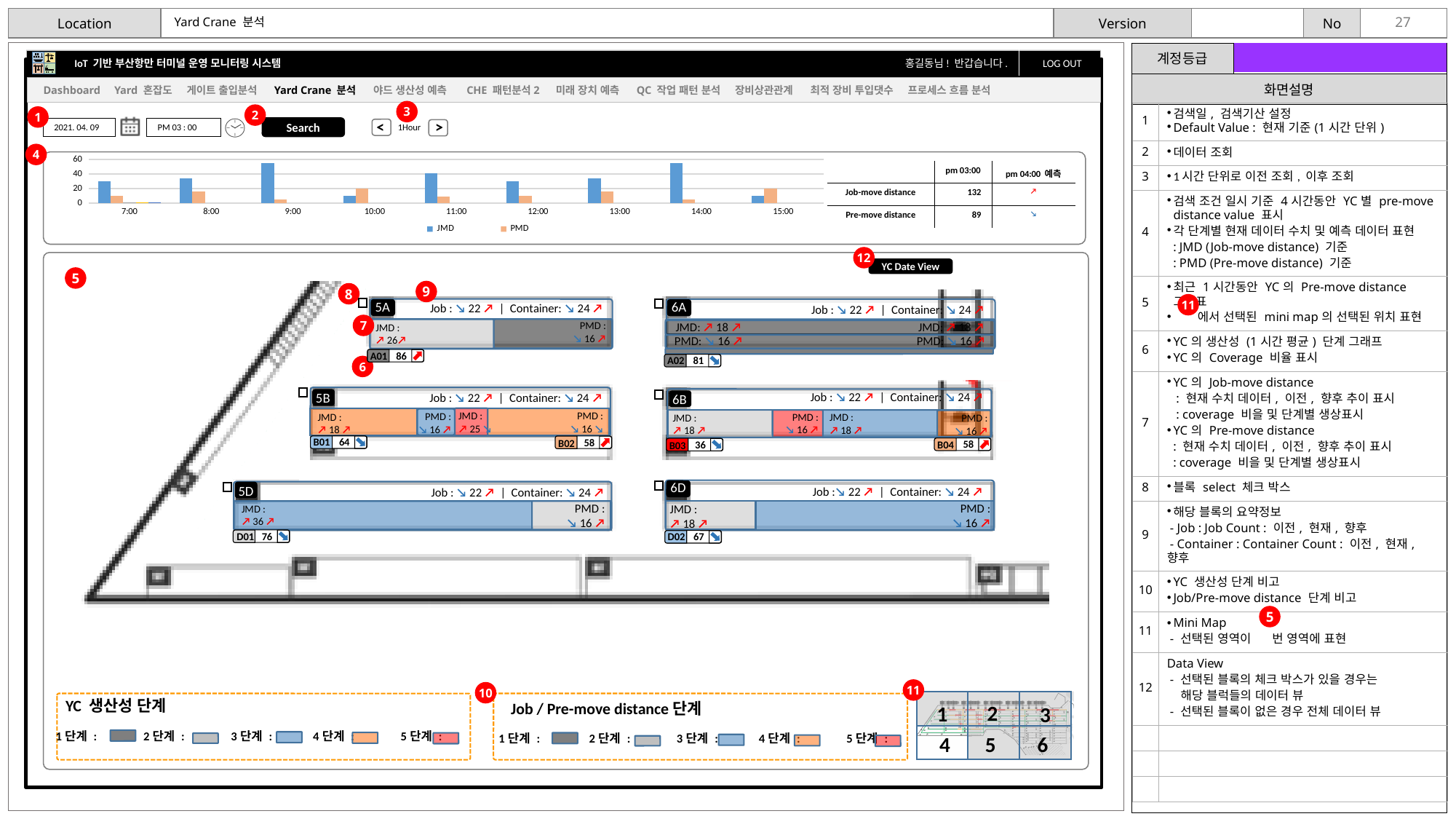
What are the two series named in the legend of the top bar chart? JMD and PMD In the top bar chart, which series has the larger value at 10:00, JMD or PMD? PMD What kind of chart is shown at the top of the slide (area 4)? bar chart What is the highest tick value shown on the y axis of the top bar chart? 60 In the top bar chart, is the JMD value at 14:00 greater or less than 40? greater In the top bar chart, is the JMD value at 10:00 greater or less than 20? less In the top bar chart, is the PMD value at 7:00 greater or less than 20? less In the top bar chart, which series has the larger value at 9:00, JMD or PMD? JMD How many series does the legend of the top bar chart list? 2 How many time categories are shown on the x axis of the top bar chart? 9